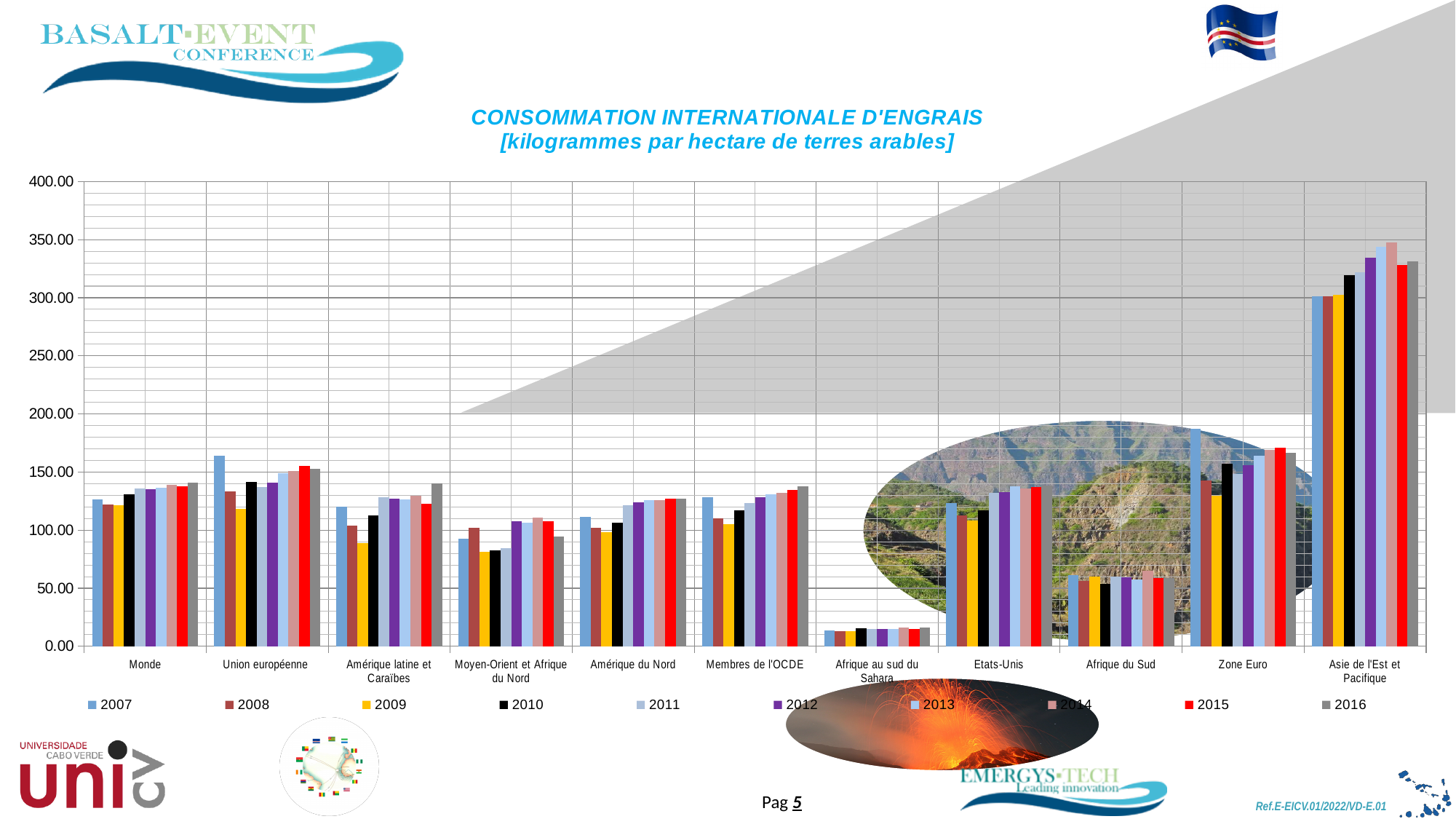
Which is larger in 2007: the value for Etats-Unis or the value for Afrique du Sud? Etats-Unis How many regions (categories) are shown on the x axis of the chart? 11 Which is larger in 2007: the value for Union européenne or the value for Monde? Union européenne What kind of chart is shown on the slide? bar chart What is the title of the chart? CONSOMMATION INTERNATIONALE D'ENGRAIS [kilogrammes par hectare de terres arables] Which region has the highest fertilizer consumption values in the chart? Asie de l'Est et Pacifique Is the 2009 value for Moyen-Orient et Afrique du Nord greater or less than 100? less Is the 2016 value for Afrique au sud du Sahara greater or less than 50? less Is the 2007 value for Union européenne greater or less than 150? greater Which region has the lowest fertilizer consumption values in the chart? Afrique au sud du Sahara How many series (years) does the legend list? 10